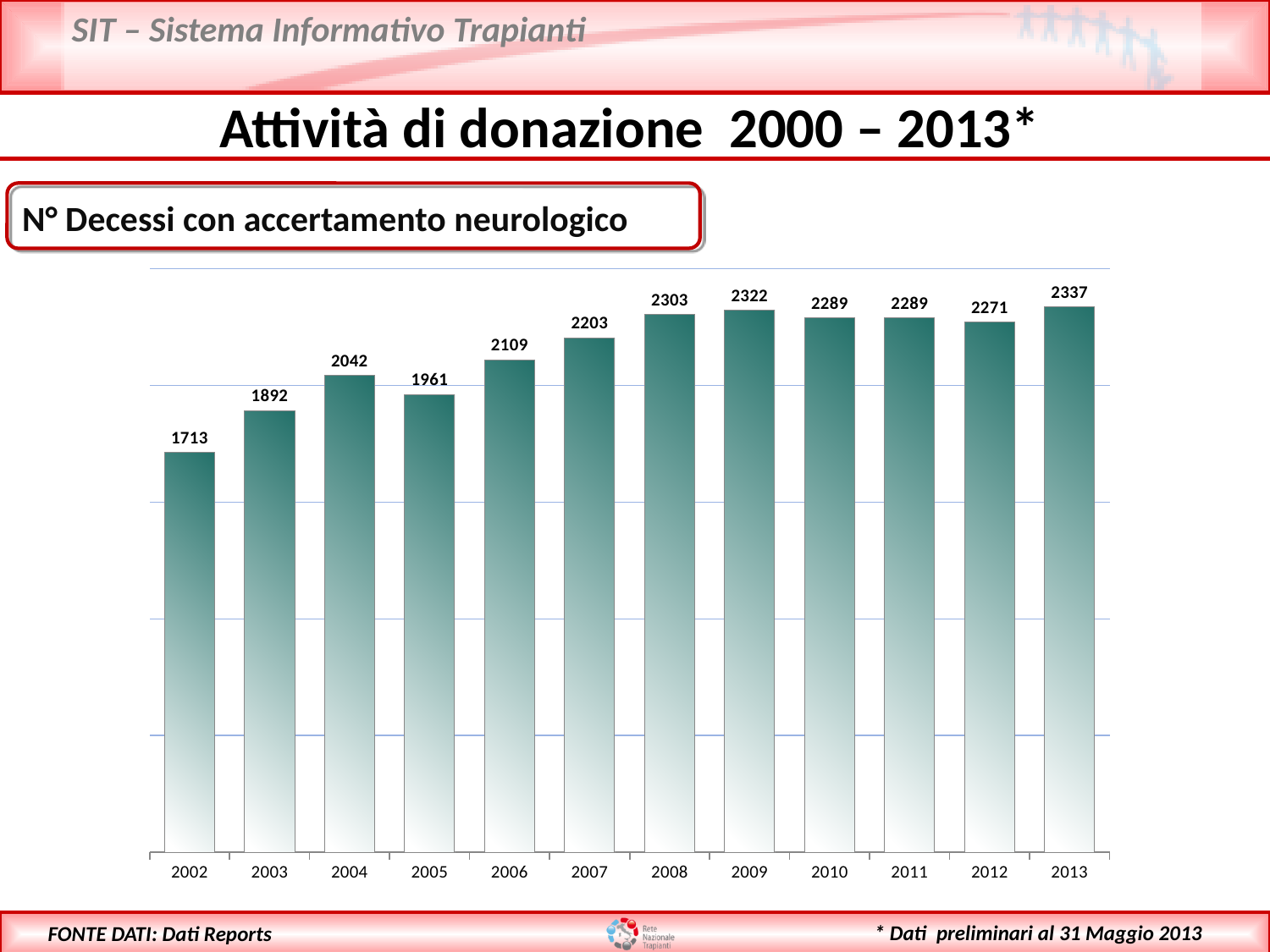
How many years are shown on the x axis? 12 What is the title of the chart? N° Decessi con accertamento neurologico What is the value for 2009? 2322 What is the value for 2013? 2337 What is the difference between the values for 2004 and 2005? 81 Which is larger, the value for 2008 or the value for 2012? 2008 What is the value for 2002? 1713 What is the difference between the values for 2013 and 2002? 624 Which year has the lowest value? 2002 What kind of chart is shown? bar chart Which year has the highest value? 2013 What is the value for 2005? 1961